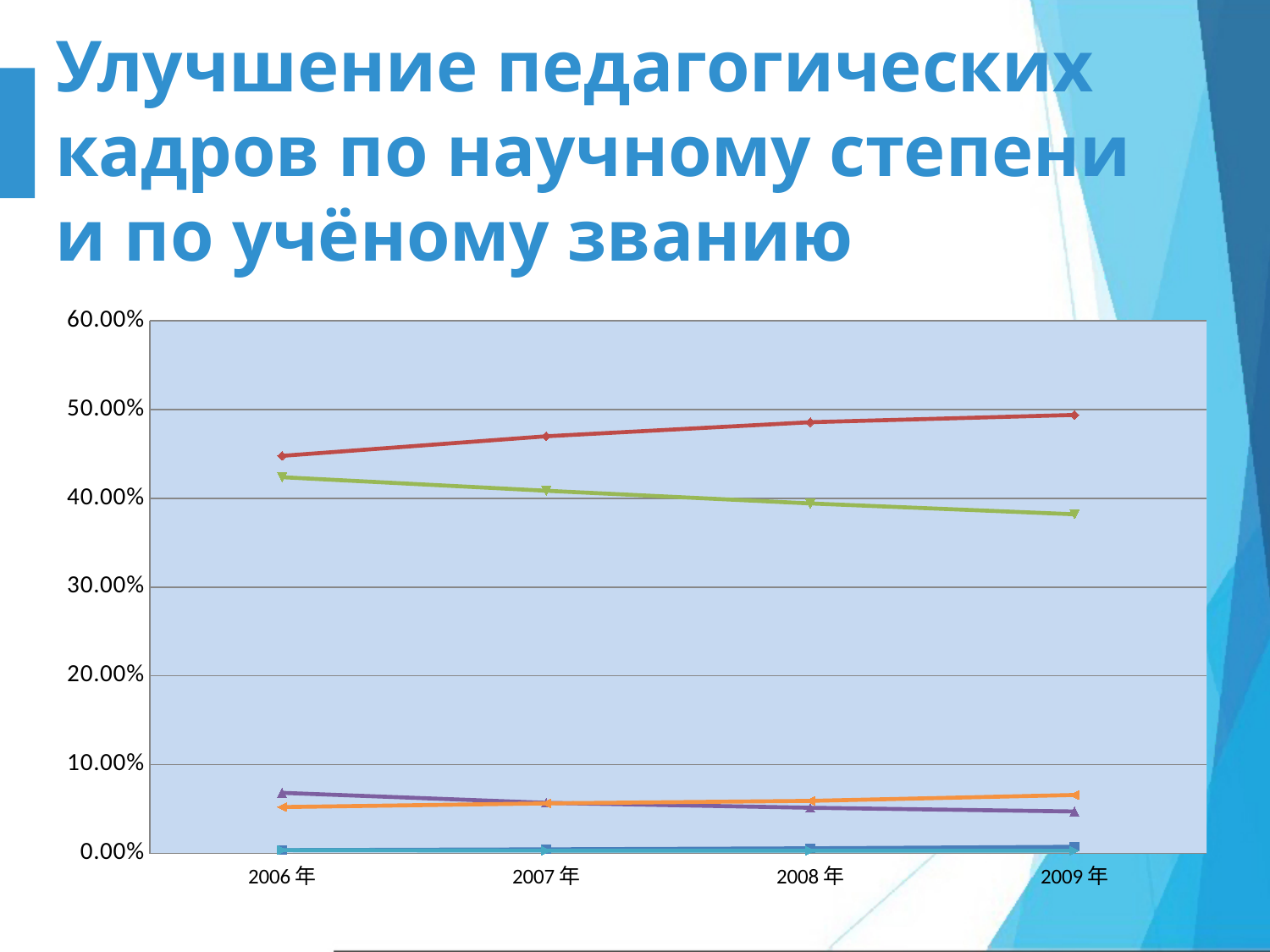
What kind of chart is shown on the slide? line chart Is the value of the green line in 2009年 greater or less than 40.00%? less What is the highest value shown on the y axis of the chart? 60.00% Does the green line rise or fall from 2006年 to 2009年? falls Is the value of the red line in 2006年 greater or less than 50.00%? less In which year does the red line reach its highest value? 2009年 Is the value of the purple line in 2006年 greater or less than 10.00%? less In which year does the green line reach its lowest value? 2009年 How many years are shown along the x axis of the chart? 4 Does the red line rise or fall from 2006年 to 2009年? rises In 2006年, which line is higher, the red line or the green line? the red line